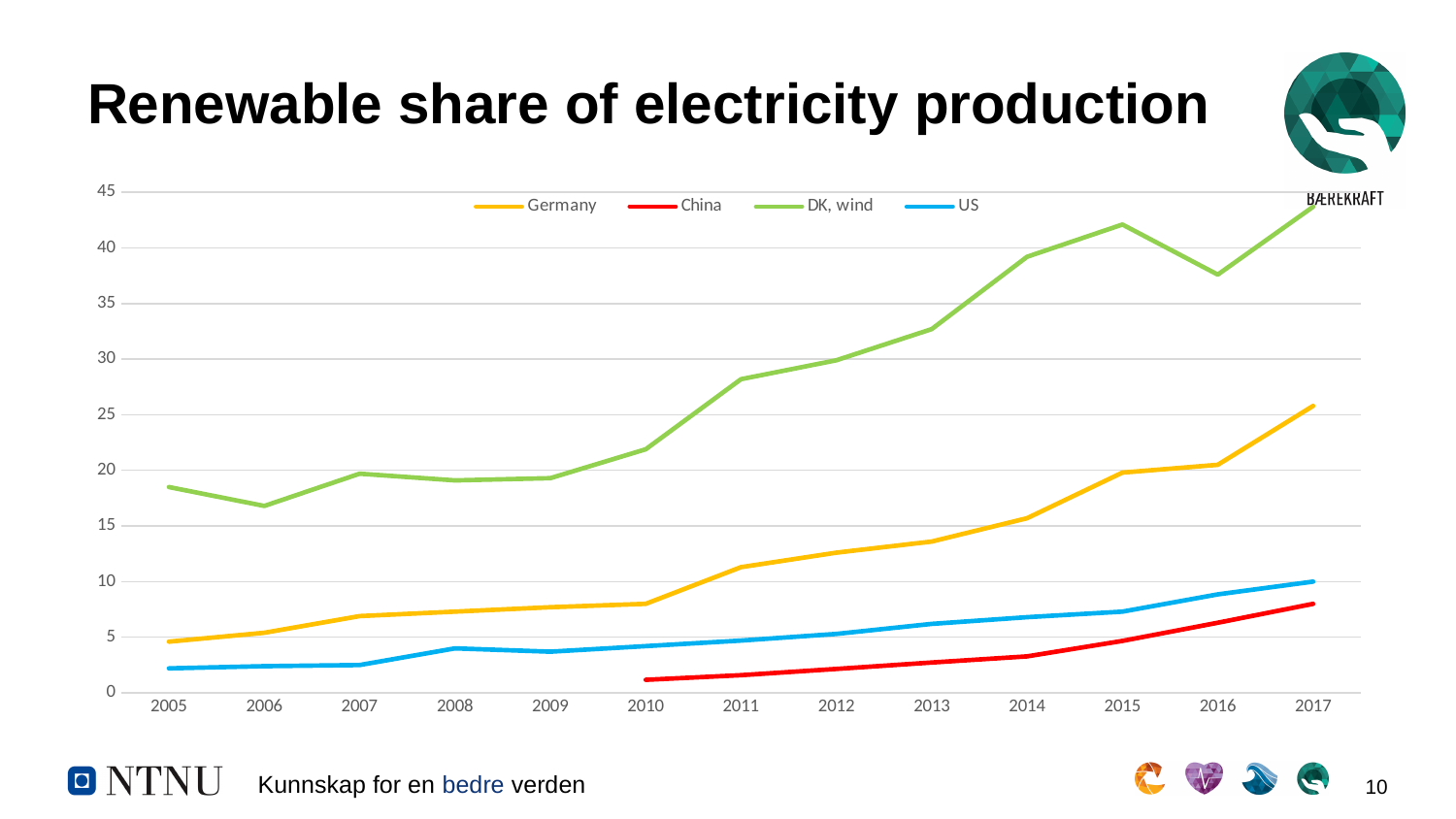
In 2015, which is larger: the value for Germany or the value for US? Germany Is the value for China in 2017 greater or less than 10? less How many series does the legend list? 4 Which series has the highest value in 2017? DK, wind How many years are shown on the x axis? 13 Is the value for Germany in 2010 greater or less than 10? less Which series has the lowest value in 2017? China In which year does the China series first appear on the chart? 2010 Is the value for DK, wind in 2017 greater or less than 40? greater For DK, wind, which year has the larger value: 2015 or 2016? 2015 Does the Germany series rise or fall from 2005 to 2017? rise What kind of chart is shown on the slide? line chart